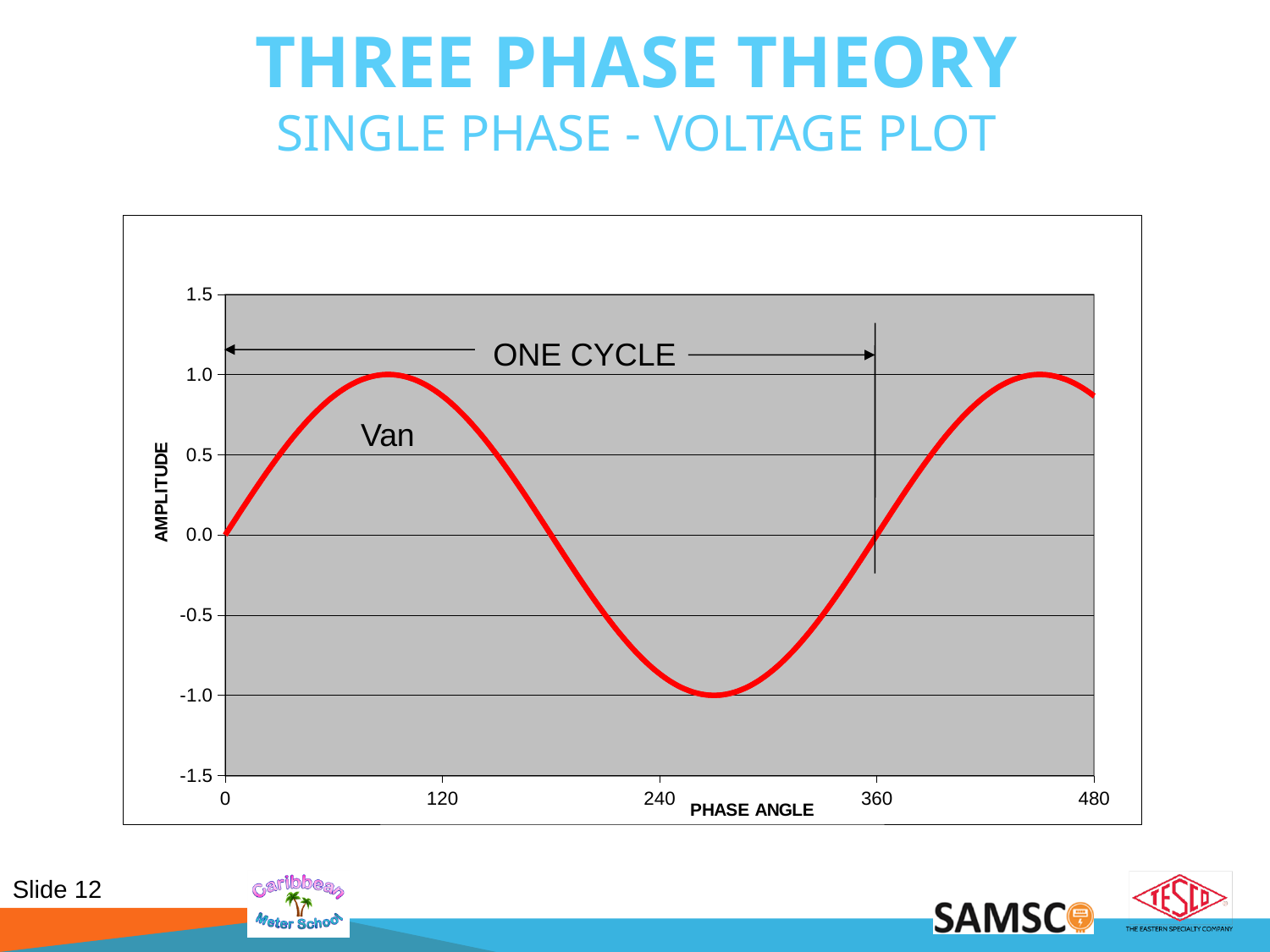
How many curves are plotted on the chart? 1 What is the label on the vertical axis of the chart? AMPLITUDE What is the maximum amplitude reached by the Van curve? 1.0 What kind of chart is shown on the slide? line chart What is the amplitude of the Van curve at a phase angle of 0? 0.0 Does the Van curve rise or fall between phase angles 120 and 240? fall Is the amplitude of the Van curve at a phase angle of 480 greater or less than 0.5? greater What is the amplitude of the Van curve at a phase angle of 360? 0.0 What is the label on the horizontal axis of the chart? PHASE ANGLE What is the minimum amplitude reached by the Van curve? -1.0 Is the amplitude of the Van curve at a phase angle of 240 greater or less than -0.5? less Is the amplitude of the Van curve at a phase angle of 120 greater or less than 0.5? greater